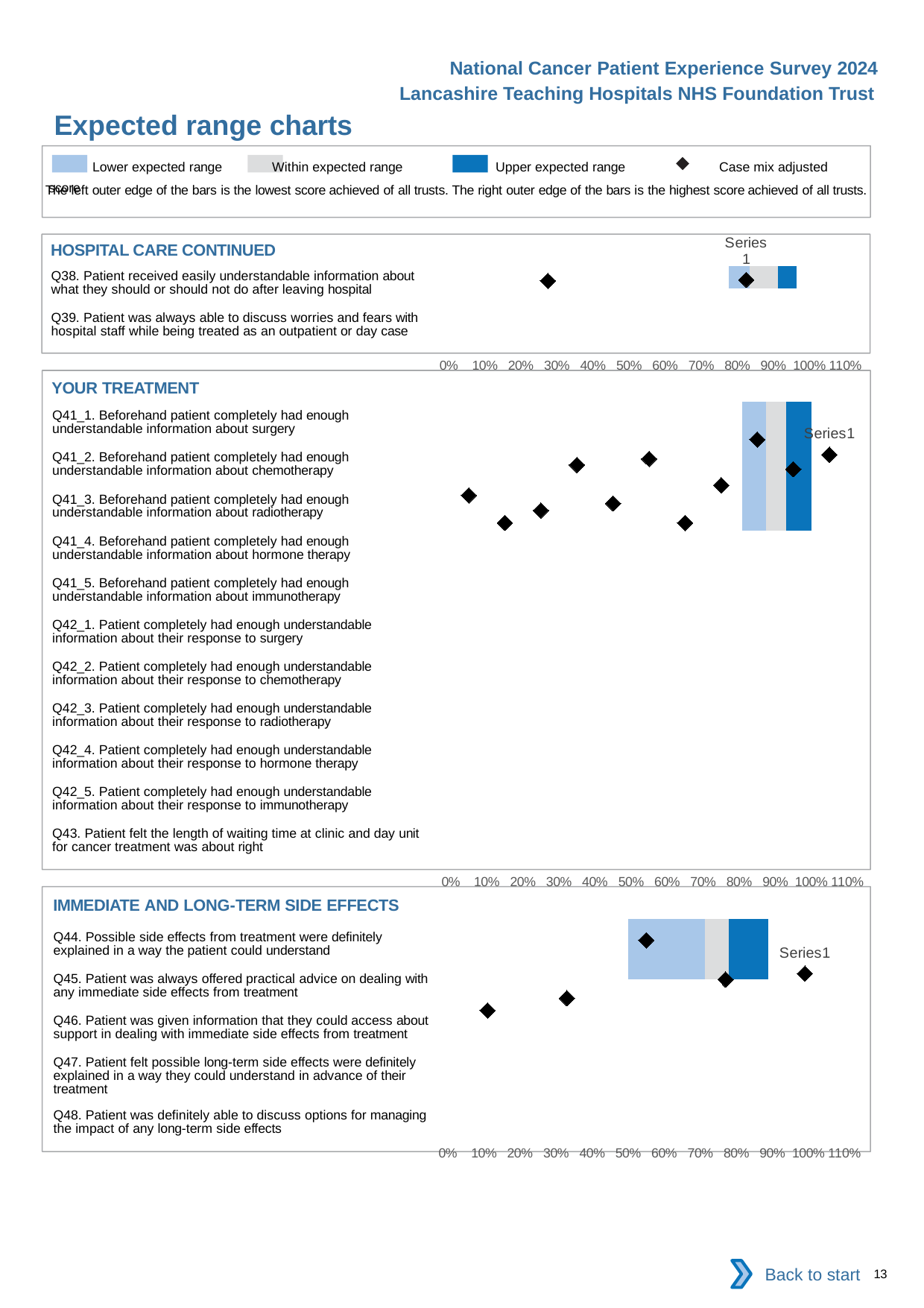
How many entries does the legend at the top of the slide list? 4 What kind of chart is used in the 'YOUR TREATMENT' section? Bar chart How many diamond markers are plotted in the 'IMMEDIATE AND LONG-TERM SIDE EFFECTS' chart? 5 How many questions (categories) are listed in the 'HOSPITAL CARE CONTINUED' chart? 2 How many diamond markers are plotted in the 'YOUR TREATMENT' chart? 11 What is the lowest tick label shown on the x axis of the 'IMMEDIATE AND LONG-TERM SIDE EFFECTS' chart? 0% What is the highest tick label shown on the x axis of the 'YOUR TREATMENT' chart? 110% According to the legend, what does the diamond marker represent? Case mix adjusted score